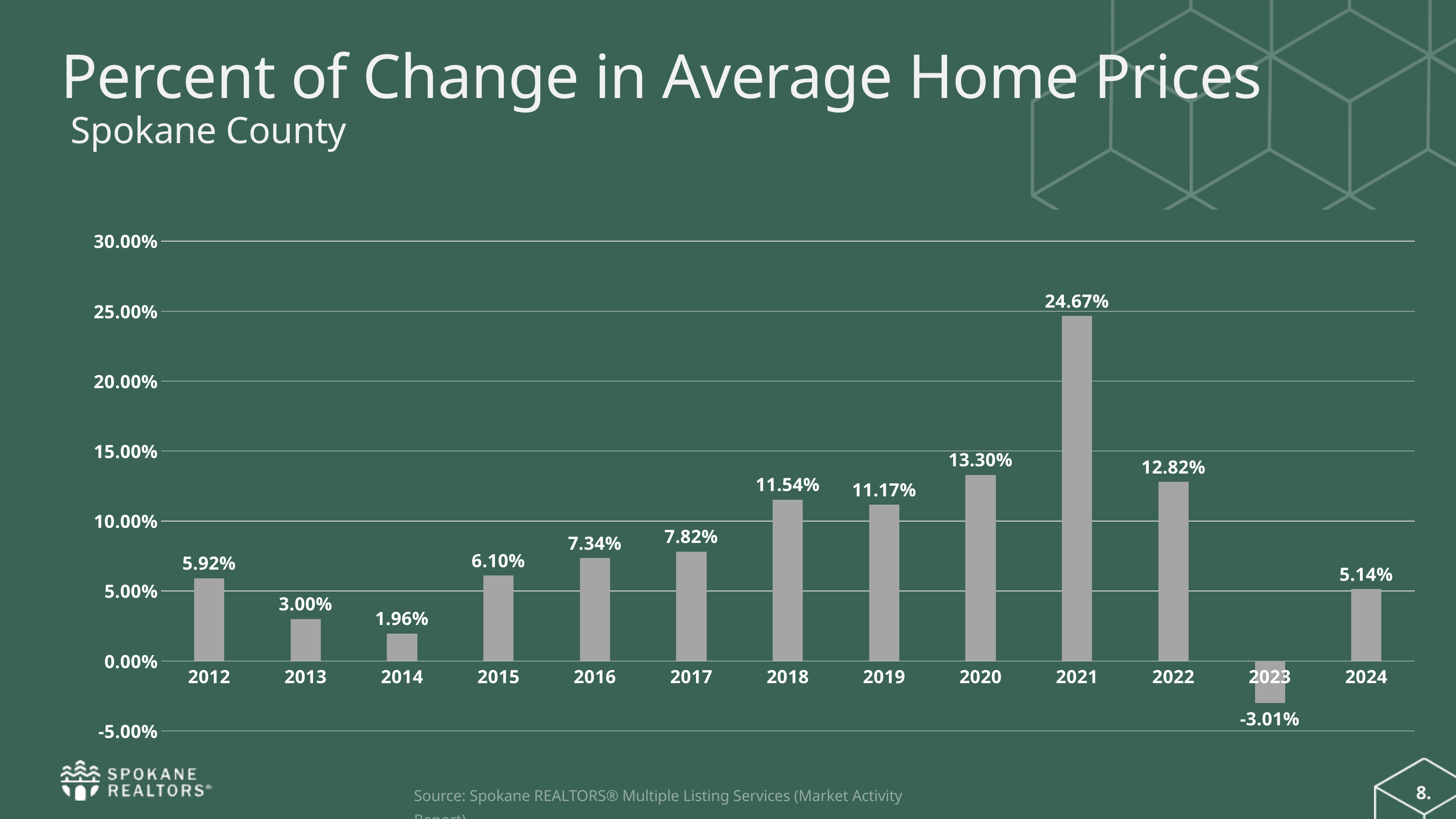
What kind of chart is shown on the slide? Bar chart Do the values rise or fall from 2012 to 2014? Fall What is the difference between the percent change in 2021 and in 2022? 11.85% Is the value for 2020 greater or less than 10.00%? greater How many years are shown on the x axis of the chart? 13 What is the percent change in average home prices for 2023? -3.01% Which year has the highest percent change in average home prices? 2021 What is the title of the chart on the slide? Percent of Change in Average Home Prices What is the percent change in average home prices for 2016? 7.34% Which year had a larger percent change in average home prices, 2018 or 2019? 2018 What is the percent change in average home prices for 2021? 24.67% Which year has the lowest percent change in average home prices? 2023